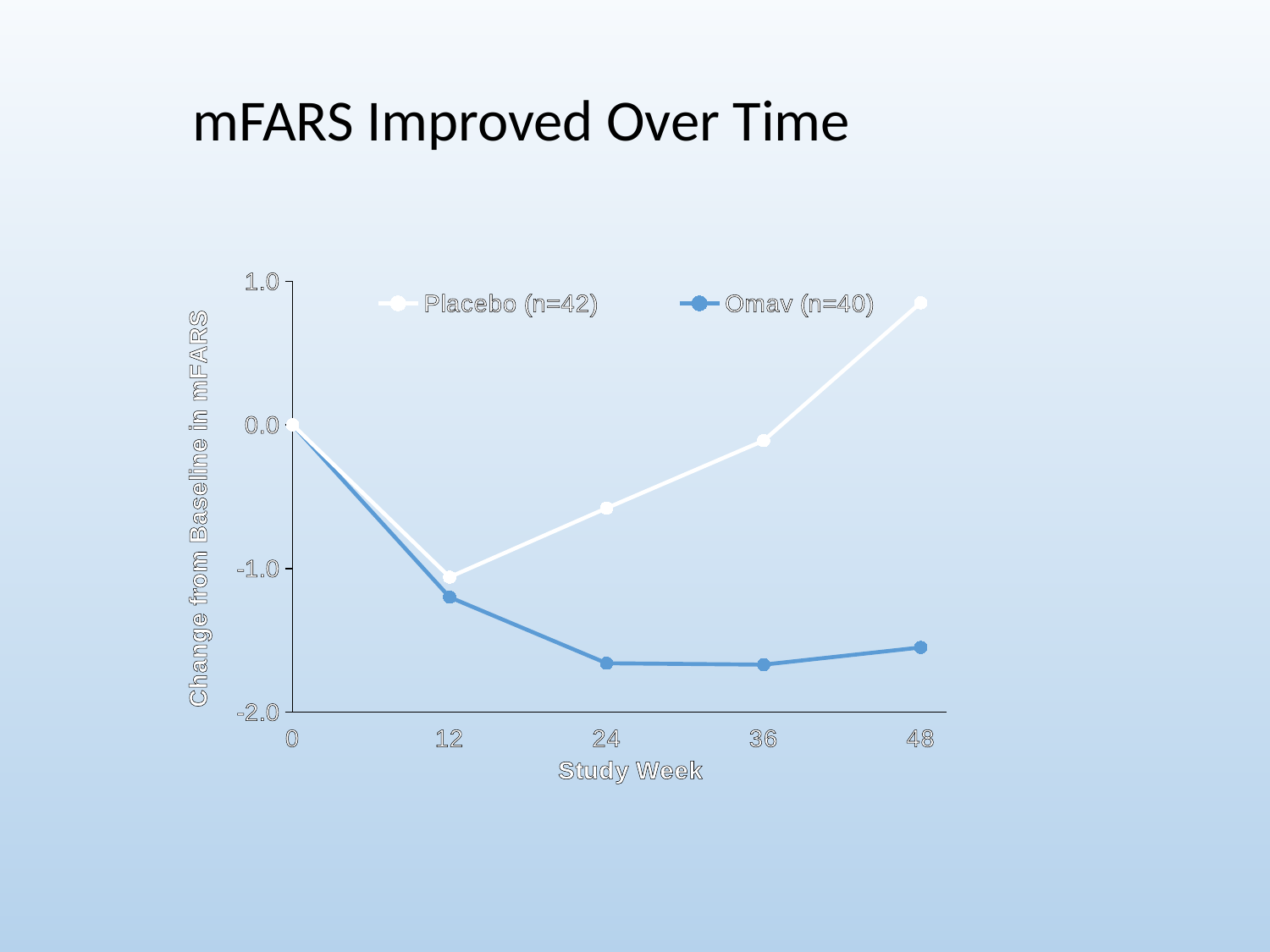
At which study week does the Placebo (n=42) series reach its highest value? 48 How many series does the legend list? 2 What kind of chart is shown on the slide? line chart Is the value for Omav (n=40) at study week 24 greater or less than -1.0? less At study week 48, which series has the higher value, Placebo (n=42) or Omav (n=40)? Placebo (n=42) How many study week points are plotted along the x axis? 5 What is the label of the y axis? Change from Baseline in mFARS What is the change from baseline in mFARS for Omav (n=40) at study week 0? 0.0 Is the value for Placebo (n=42) at study week 24 greater or less than -1.0? greater At which study week does the Placebo (n=42) series reach its lowest value? 12 Is the value for Placebo (n=42) at study week 48 greater or less than 0.0? greater Does the Placebo (n=42) series rise or fall between study week 12 and study week 48? rise